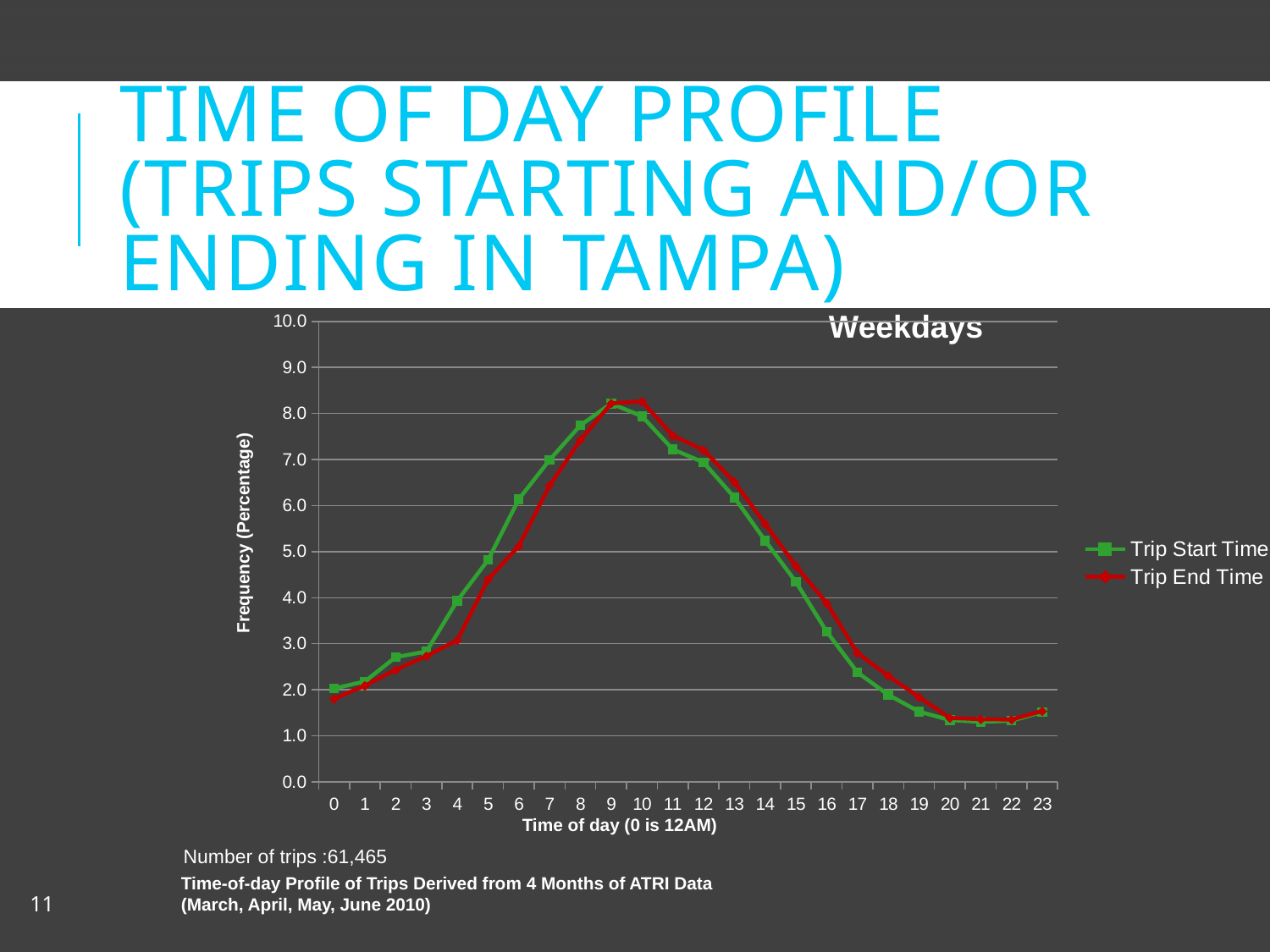
How many series does the legend list? 2 At which hour does the Trip Start Time series reach its highest value? 9 Is the Trip End Time value at hour 17 greater or less than 3.0? less Is the Trip Start Time value at hour 8 greater or less than 7.0? greater How many time-of-day categories are plotted along the x axis? 24 What kind of chart is shown on the slide? line chart What is the title of the y axis? Frequency (Percentage) Do the Trip Start Time values rise or fall from hour 9 to hour 20? fall Is the Trip Start Time value at hour 14 greater or less than 5.0? greater At hour 11, which series has the larger value, Trip Start Time or Trip End Time? Trip End Time At hour 6, which series has the larger value, Trip Start Time or Trip End Time? Trip Start Time